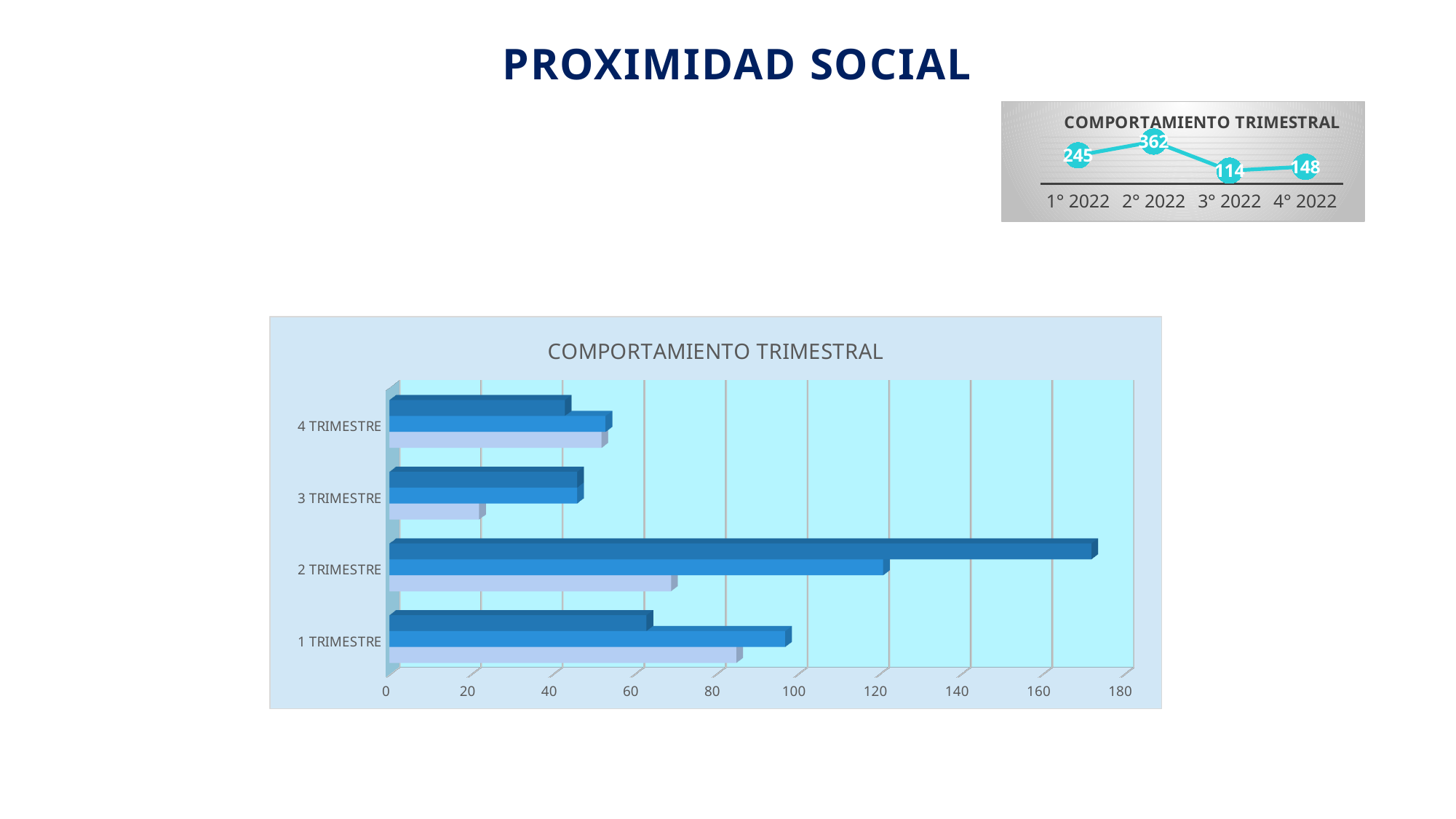
In the small line chart at the top right, how many data points are plotted? 4 In the small line chart at the top right, what is the value for 1° 2022? 245 In the large bar chart, how many categories are shown on the vertical axis? 4 In the small line chart at the top right, which quarter has the highest value? 2° 2022 What kind of chart is the large chart in the lower part of the slide? bar chart In the small line chart at the top right, does the value rise or fall from 2° 2022 to 3° 2022? fall In the large bar chart, is the longest bar for 2 TRIMESTRE greater or less than 160? greater In the small line chart at the top right, which quarter has the lowest value? 3° 2022 In the large bar chart, is the shortest bar for 3 TRIMESTRE greater or less than 40? less In the small line chart at the top right, what is the difference between the values for 2° 2022 and 1° 2022? 117 In the small line chart at the top right, which is larger, the value for 4° 2022 or the value for 3° 2022? 4° 2022 In the small line chart at the top right, what is the value for 3° 2022? 114